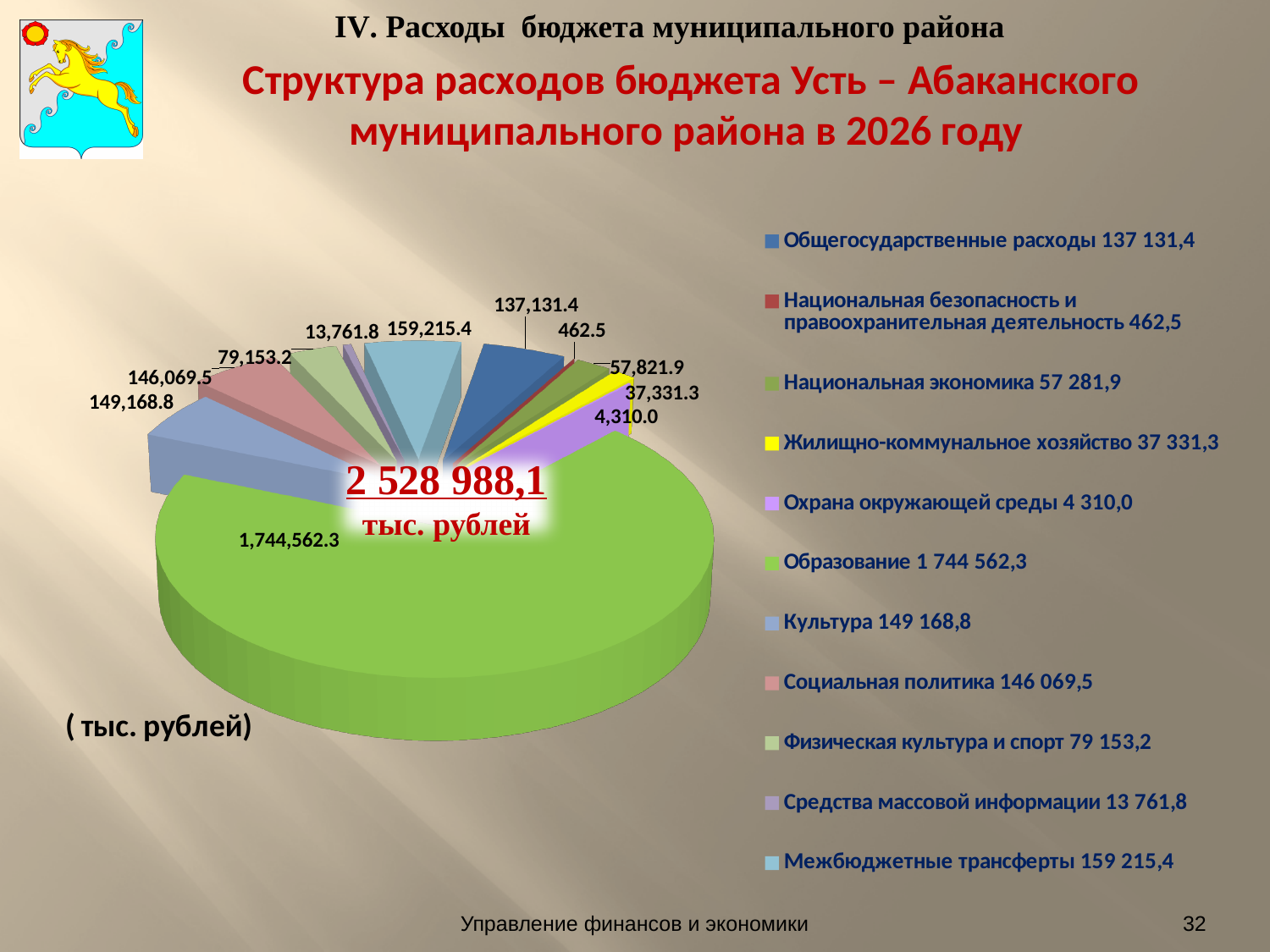
What kind of chart is shown on the slide? Pie chart What is the value for Культура? 149 168,8 What is the value for Жилищно-коммунальное хозяйство? 37 331,3 What total amount is printed in the centre of the pie chart? 2 528 988,1 тыс. рублей Which is larger, Средства массовой информации or Охрана окружающей среды? Средства массовой информации Which expenditure category has the smallest value in the pie chart? Национальная безопасность и правоохранительная деятельность How many expenditure categories does the pie chart show? 11 Which is larger, Культура or Социальная политика? Культура What is the value for Охрана окружающей среды? 4 310,0 Which expenditure category has the largest share of the pie? Образование What is the difference between Социальная политика and Физическая культура и спорт? 66 916,3 What is the value for Межбюджетные трансферты? 159 215,4